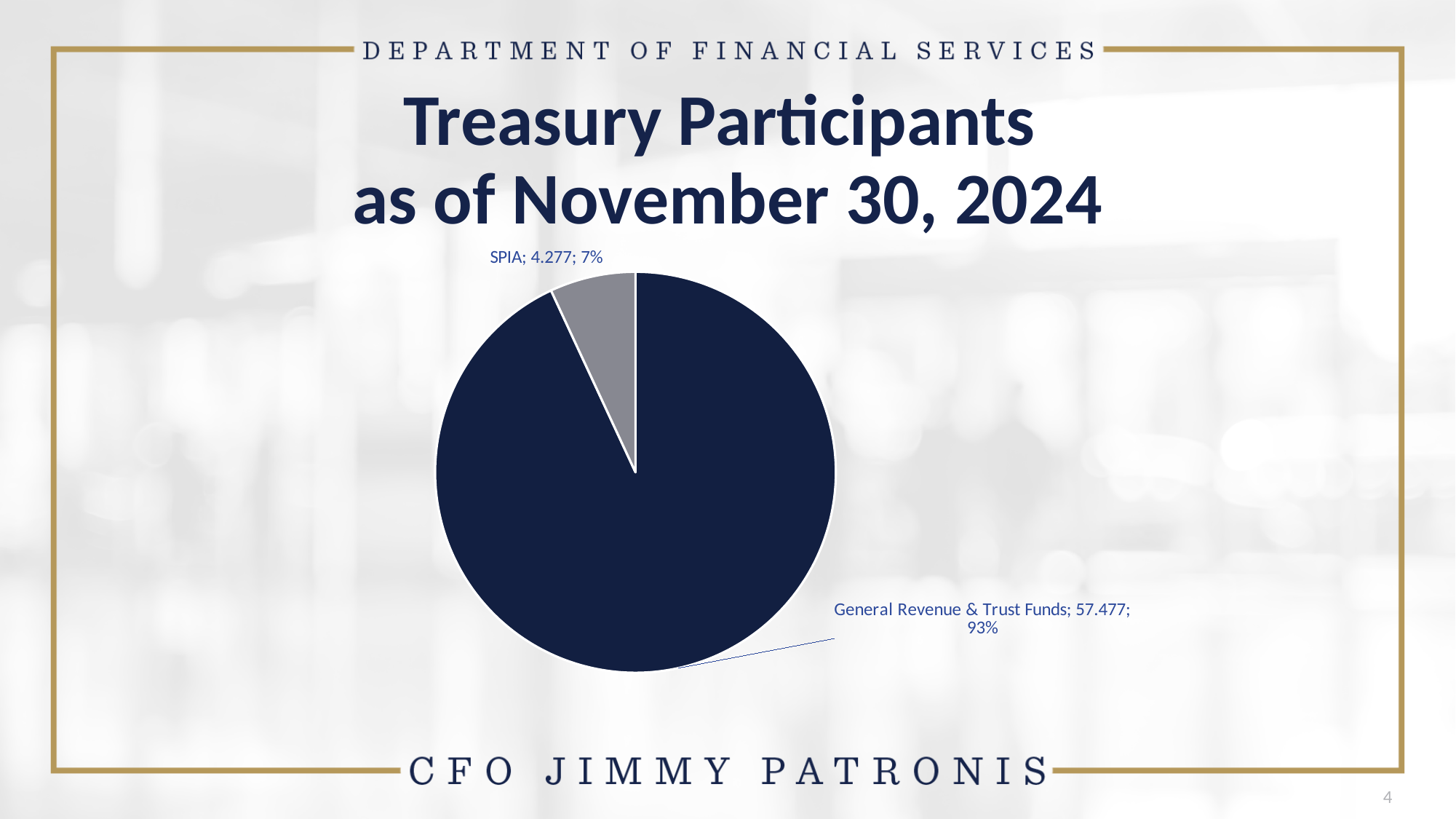
Which is larger, the value for SPIA or the value for General Revenue & Trust Funds? General Revenue & Trust Funds What is the total of the two slice values? 61.754 What is the title of the chart on the slide? Treasury Participants as of November 30, 2024 Which category has the smallest slice? SPIA What kind of chart is shown on the slide? Pie chart Which category has the largest slice? General Revenue & Trust Funds What is the value for General Revenue & Trust Funds? 57.477 How many slices does the pie chart have? 2 What share of the pie does SPIA represent? 7% What share of the pie does General Revenue & Trust Funds represent? 93% What is the value for SPIA? 4.277 What is the difference between the General Revenue & Trust Funds value and the SPIA value? 53.200